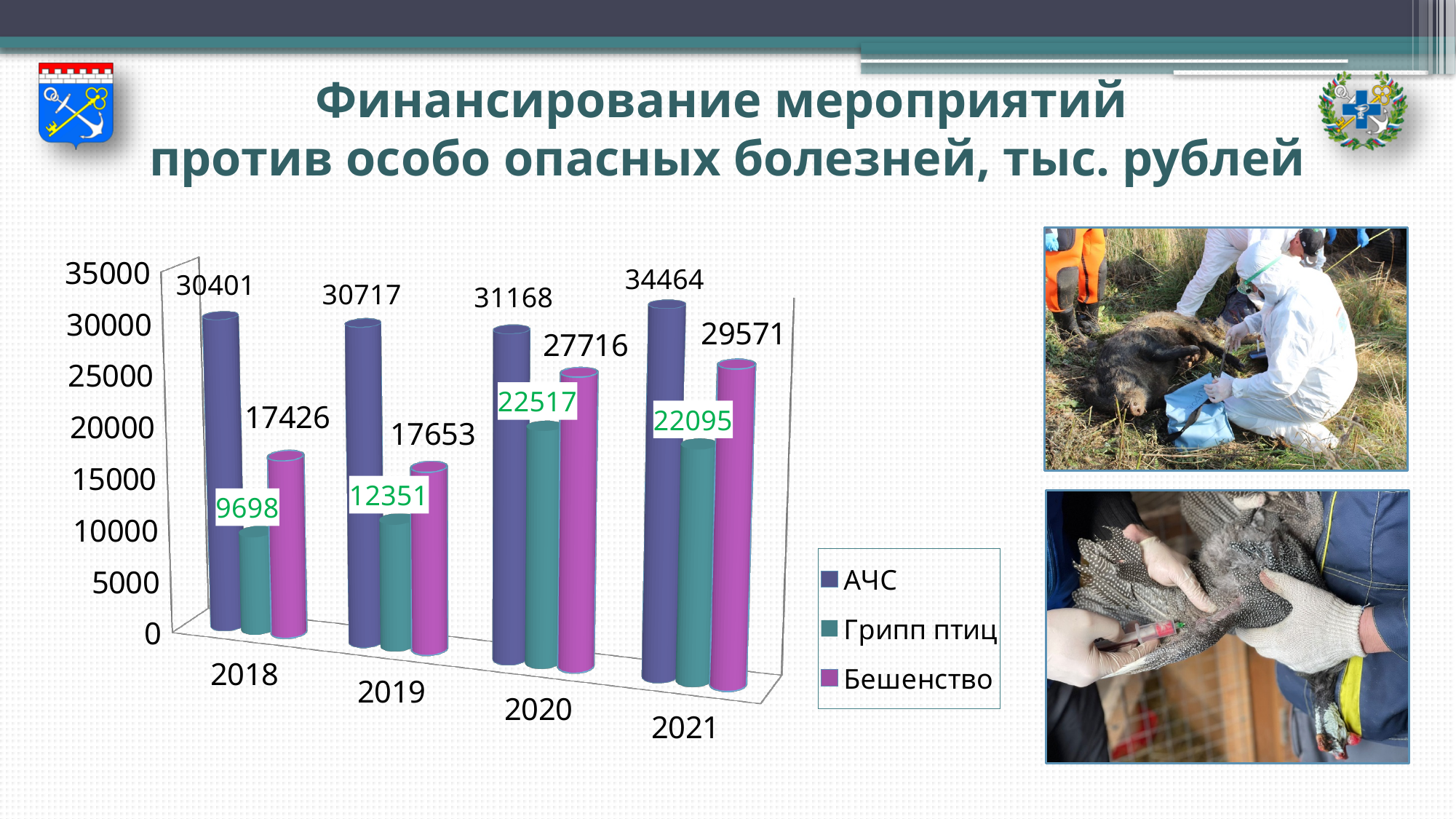
Does the funding for АЧС rise or fall from 2018 to 2021? Rise What was the funding for АЧС in 2021? 34464 What kind of chart is shown on the slide? Bar chart In which year was the funding for АЧС the highest? 2021 In which year was the funding for Грипп птиц the lowest? 2018 Which received more funding in 2020: Грипп птиц or Бешенство? Бешенство How many series does the legend list? 3 How many years are shown on the x axis? 4 What was the funding for Бешенство in 2020? 27716 What was the funding for Грипп птиц in 2018? 9698 Which series is shown in magenta in the legend? Бешенство What is the difference between the АЧС funding and the Бешенство funding in 2019? 13064